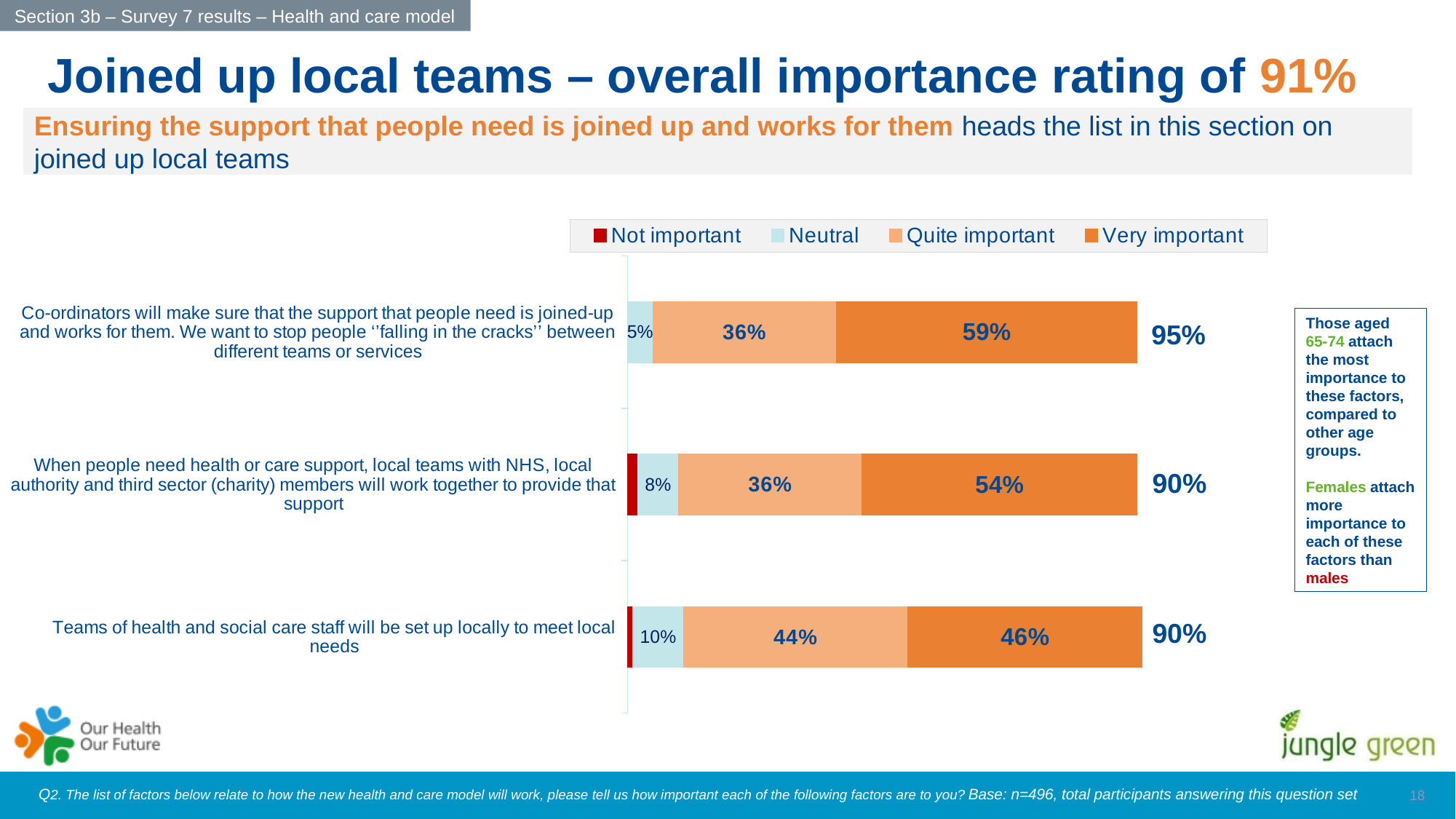
What is the 'Very important' value for 'Co-ordinators will make sure that the support that people need is joined-up and works for them'? 59% How many categories (factors) are plotted in the chart? 3 What is the combined 'Quite important' and 'Very important' total shown for the co-ordinators factor? 95% What is the 'Quite important' value for 'Teams of health and social care staff will be set up locally to meet local needs'? 44% What kind of chart is shown on the slide? Stacked bar chart How many series does the legend list? 4 What is the 'Neutral' value for 'When people need health or care support, local teams with NHS, local authority and third sector (charity) members will work together to provide that support'? 8% Which factor has the highest 'Very important' value? Co-ordinators will make sure that the support that people need is joined-up and works for them Which factor has the lowest 'Very important' value? Teams of health and social care staff will be set up locally to meet local needs Which legend entry is shown in dark red? Not important